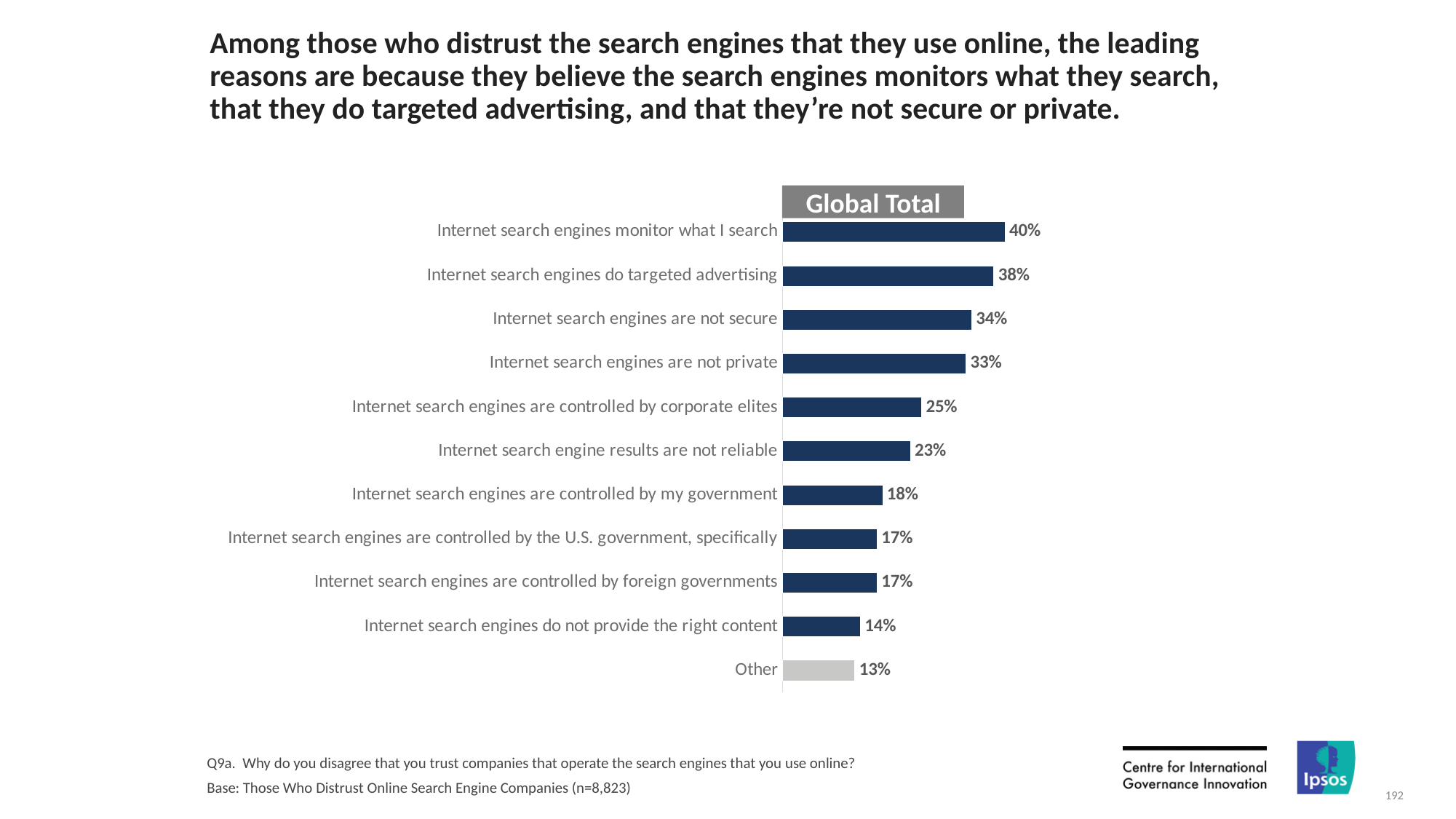
What is the difference between 'Internet search engines do targeted advertising' and 'Internet search engines are not secure'? 4% What percentage of respondents said Internet search engines monitor what I search? 40% What is the value for 'Internet search engines are controlled by corporate elites'? 25% What percentage chose 'Other' as a reason? 13% Which reason has the lowest percentage? Other Which two reasons both have a value of 17%? Internet search engines are controlled by the U.S. government, specifically; Internet search engines are controlled by foreign governments Which reason has the highest percentage? Internet search engines monitor what I search What is the difference between the highest value and the 'Other' value? 27% How many reasons (categories) are shown in the chart? 11 What kind of chart is shown on the slide? Bar chart What is the label shown in the grey box above the bars? Global Total Which is larger: 'Internet search engines are controlled by my government' or 'Internet search engines do not provide the right content'? Internet search engines are controlled by my government